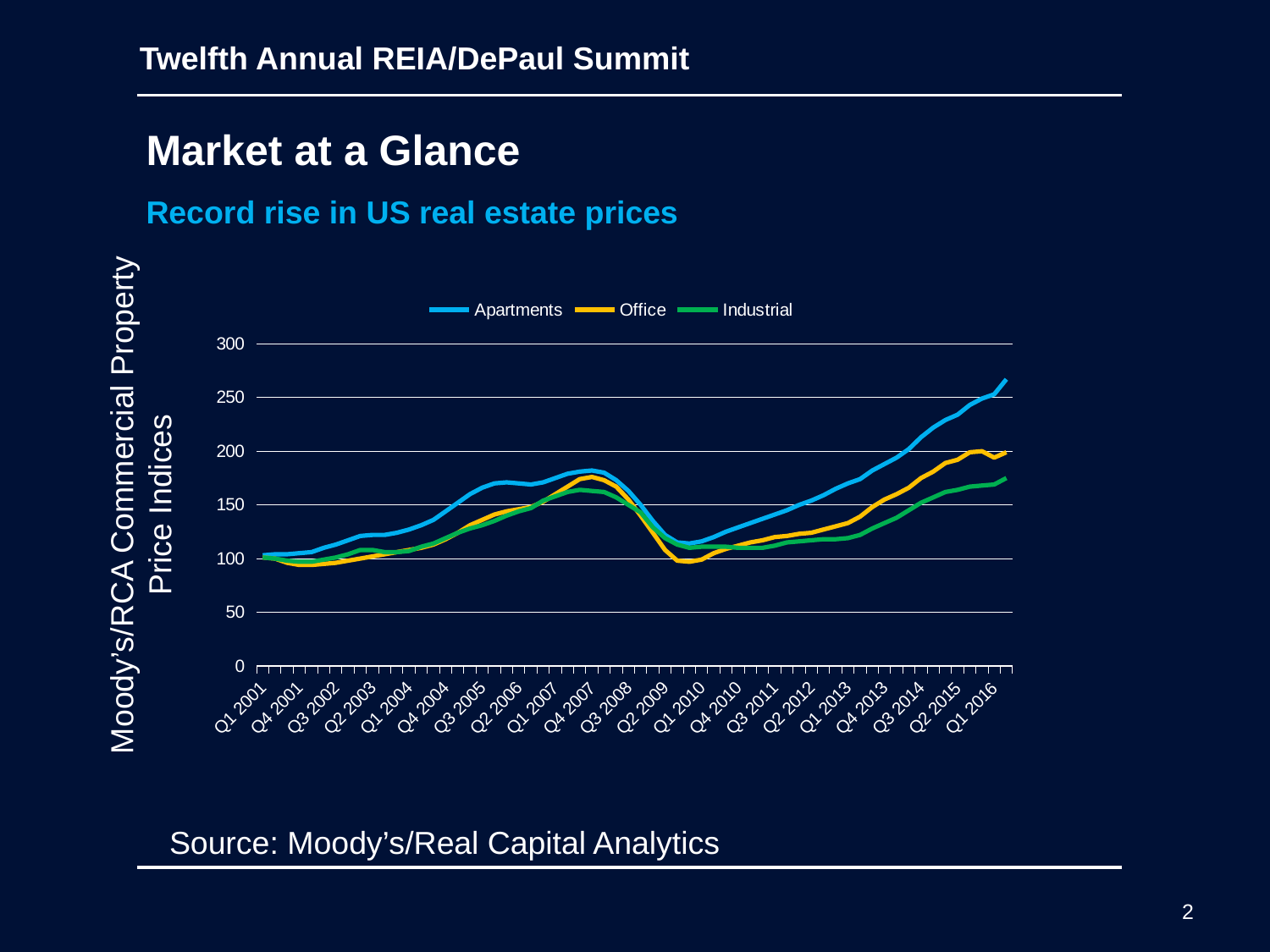
What kind of chart is shown on the slide? line chart How many series does the legend list? 3 Is the value for Industrial at Q1 2016 greater or less than 200? less Does the Apartments series rise or fall between Q1 2010 and Q1 2016? rise What is the title of the vertical axis? Moody's/RCA Commercial Property Price Indices Which series has the highest value at Q1 2016? Apartments Which series has the lowest value at Q1 2016? Industrial Is the value for Industrial at Q1 2016 greater or less than 150? greater At Q1 2016, which is larger, the Office value or the Industrial value? Office Which series are listed in the chart legend? Apartments, Office, Industrial Is the value for Apartments at Q4 2007 greater or less than 150? greater